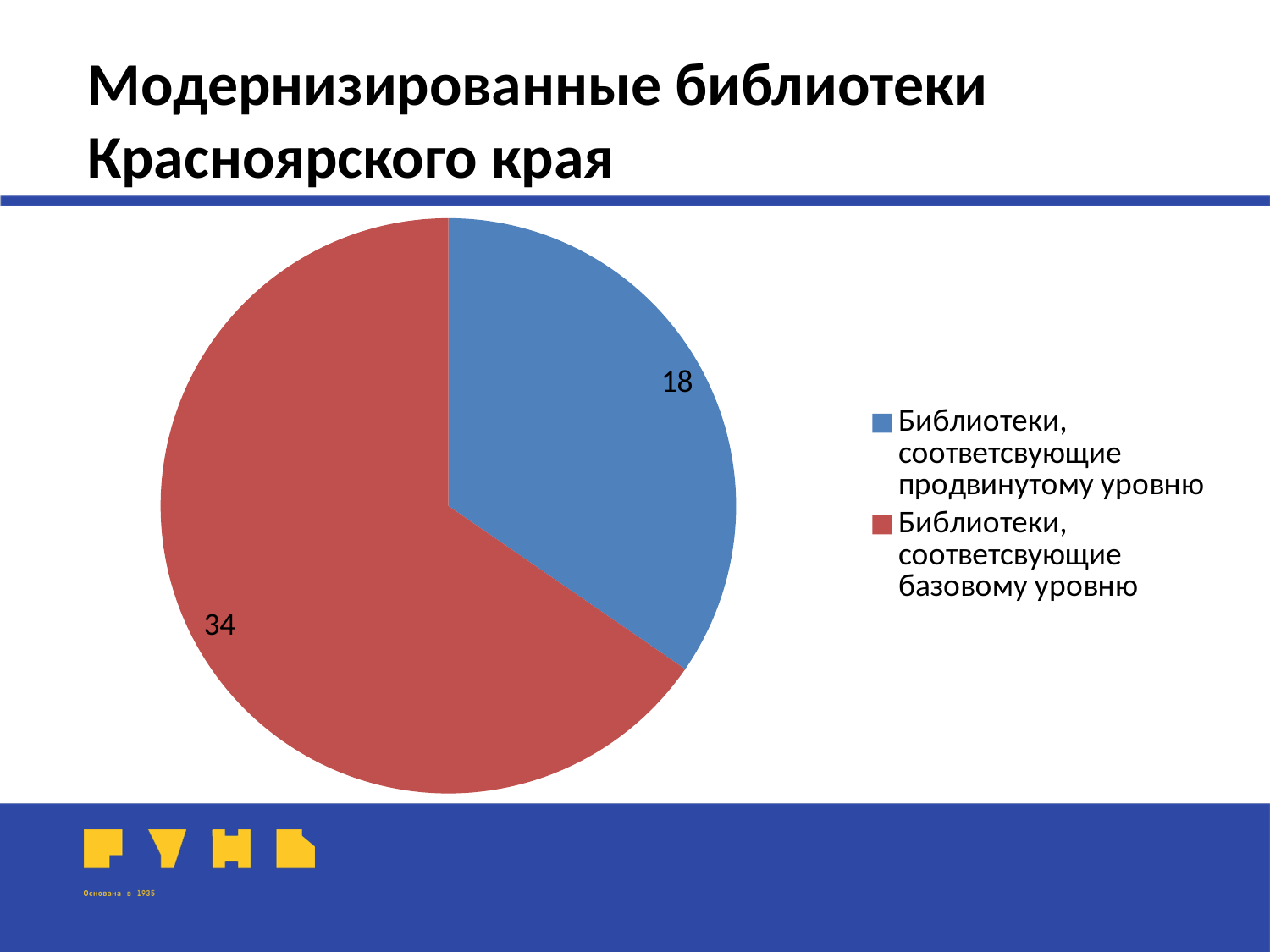
What is the value for 'Библиотеки, соответсвующие продвинутому уровню'? 18 What is the title of the slide containing the chart? Модернизированные библиотеки Красноярского края Which category has the largest slice of the pie? Библиотеки, соответсвующие базовому уровню How many entries does the legend list? 2 How many slices does the pie chart have? 2 What is the value for 'Библиотеки, соответсвующие базовому уровню'? 34 What is the difference between the value for libraries at the basic level and the value for libraries at the advanced level? 16 Which category has the smallest slice of the pie? Библиотеки, соответсвующие продвинутому уровню What colour is the slice for 'Библиотеки, соответсвующие базовому уровню'? red Which is larger: the value for 'Библиотеки, соответсвующие базовому уровню' or the value for 'Библиотеки, соответсвующие продвинутому уровню'? Библиотеки, соответсвующие базовому уровню What kind of chart is shown on the slide? pie chart What is the total of the two values shown in the pie chart? 52